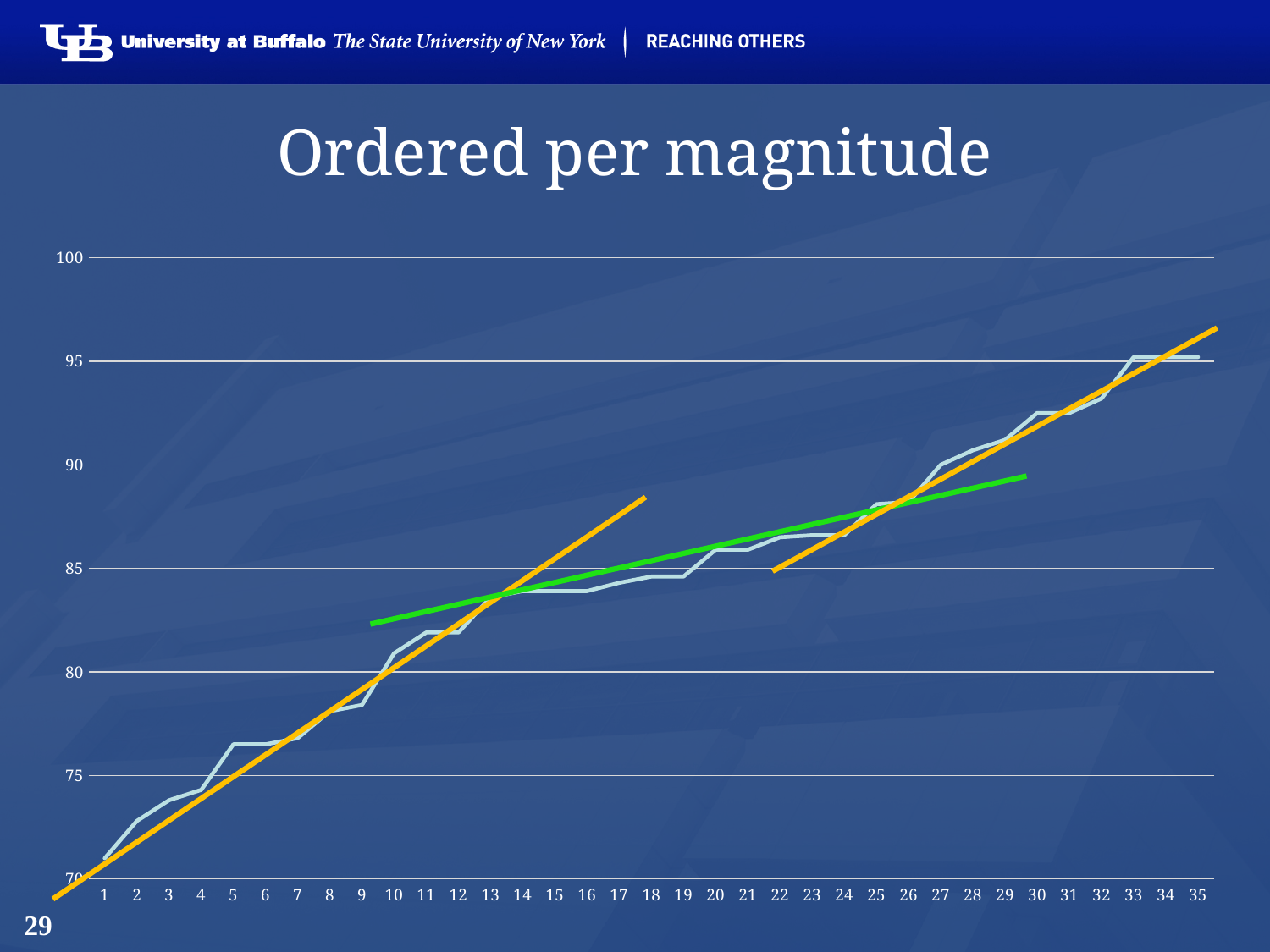
Is the value at point 30 greater or less than 90? greater Which is larger, the value at point 10 or the value at point 25? point 25 Do the values of the light blue line rise or fall as the x axis goes from 1 to 35? rise Which x-axis point has the lowest value on the light blue line? 1 What are the lowest and highest values labelled on the y axis? 70 and 100 Is the value at point 16 greater or less than 85? less How many points are plotted along the x axis? 35 Is the value at point 33 greater or less than 90? greater What kind of chart is shown on the slide? line chart What is the title of the chart? Ordered per magnitude